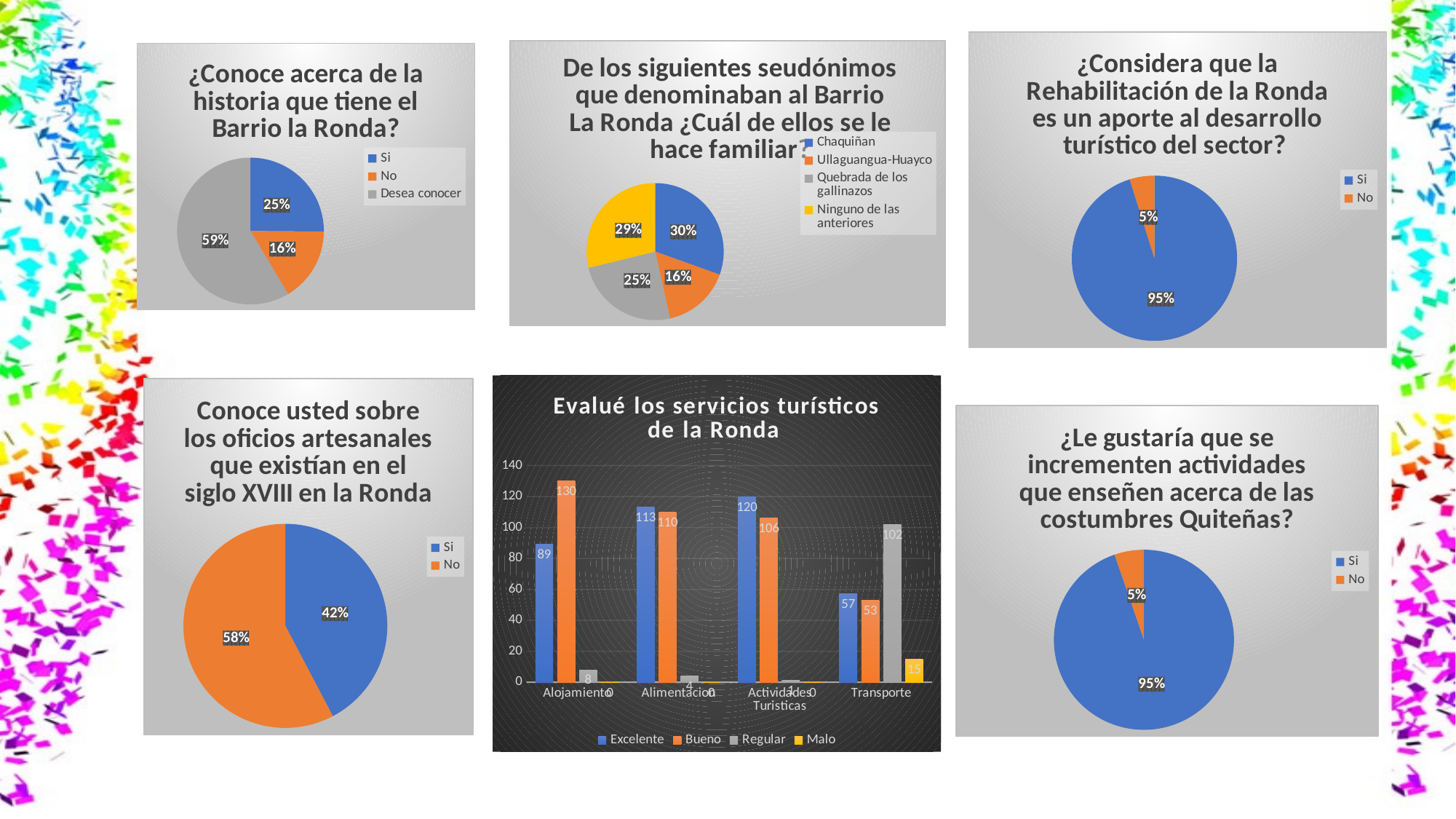
In the chart titled '¿Conoce acerca de la historia que tiene el Barrio la Ronda?', which category has the smallest share? No In the chart titled 'Conoce usted sobre los oficios artesanales que existían en el siglo XVIII en la Ronda', which answer has the larger share, 'Si' or 'No'? No In the chart titled '¿Conoce acerca de la historia que tiene el Barrio la Ronda?', what percentage is shown for 'Desea conocer'? 59% In the chart about the seudónimos of Barrio La Ronda, how many categories does the legend list? 4 In the chart about the seudónimos of Barrio La Ronda, what percentage is shown for 'Chaquiñan'? 30% In the chart titled '¿Considera que la Rehabilitación de la Ronda es un aporte al desarrollo turístico del sector?', what percentage answered 'Si'? 95% In the chart titled 'Evalué los servicios turísticos de la Ronda', what is the value for 'Bueno' in 'Alojamiento'? 130 What kind of chart is 'Evalué los servicios turísticos de la Ronda'? Bar chart In the chart titled 'Evalué los servicios turísticos de la Ronda', how many series does the legend list? 4 In the chart about the seudónimos of Barrio La Ronda, what is the difference between the shares for 'Chaquiñan' and 'Ullaguangua-Huayco'? 14% In the chart titled 'Evalué los servicios turísticos de la Ronda', what is the value for 'Regular' in 'Transporte'? 102 In the chart titled '¿Le gustaría que se incrementen actividades que enseñen acerca de las costumbres Quiteñas?', what percentage answered 'No'? 5%